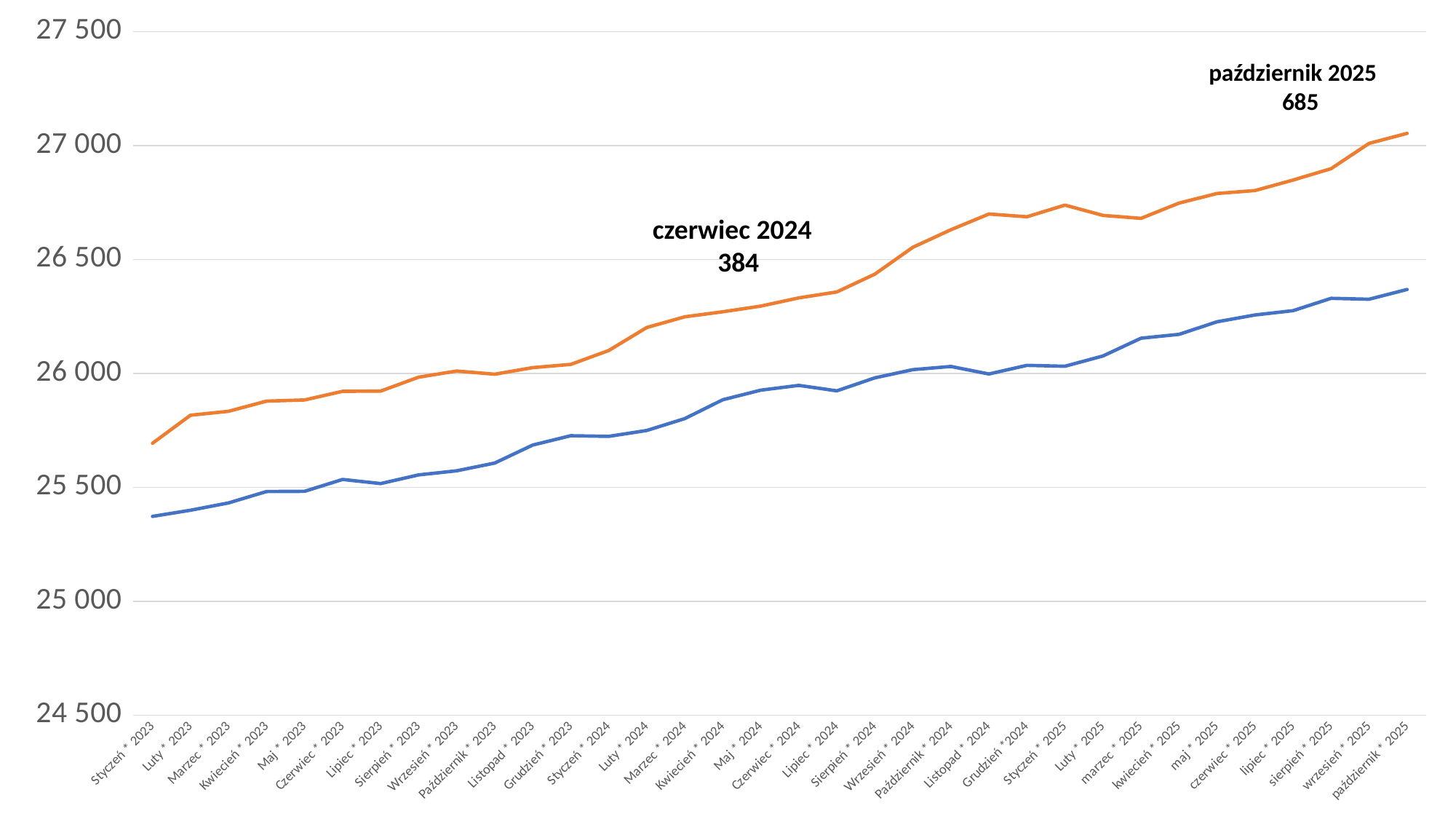
Is the value of the blue line at Styczeń 2023 greater or less than 25 500? less Is the value of the blue line at październik 2025 greater or less than 26 500? less Which month is the first category on the x axis? Styczeń * 2023 At Czerwiec 2024, which line has the higher value, the orange line or the blue line? the orange line Which month is the last category on the x axis? październik * 2025 Is the value of the orange line at Styczeń 2023 greater or less than 26 000? less Do the values of the blue line rise or fall from Styczeń 2023 to październik 2025? rise What kind of chart is shown on the slide? line chart How many lines are plotted on the chart? 2 How many monthly points are shown along the x axis? 34 Do the values of the orange line rise or fall from Styczeń 2023 to październik 2025? rise